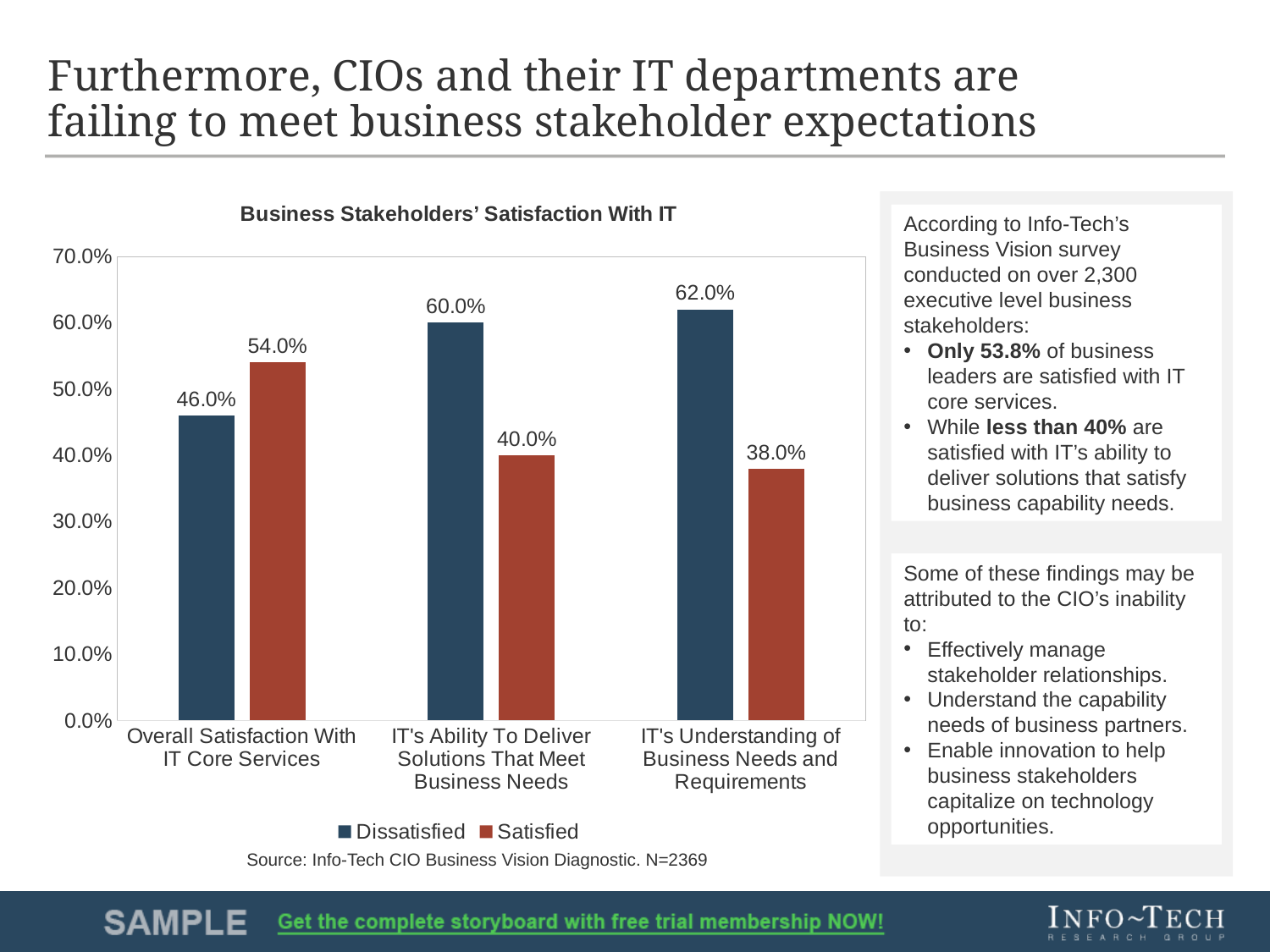
What is the title of the chart? Business Stakeholders' Satisfaction With IT What is the difference between the Dissatisfied and Satisfied values for IT's Ability To Deliver Solutions That Meet Business Needs? 20.0% What is the Satisfied value for IT's Ability To Deliver Solutions That Meet Business Needs? 40.0% How many categories are shown on the x axis? 3 What kind of chart is shown on the slide? Bar chart Which colour represents the Satisfied series in the legend? Red How many series does the legend list? 2 For Overall Satisfaction With IT Core Services, which is larger: the Dissatisfied value or the Satisfied value? Satisfied Which category has the lowest Satisfied value? IT's Understanding of Business Needs and Requirements What is the Dissatisfied value for IT's Understanding of Business Needs and Requirements? 62.0% Which category has the highest Dissatisfied value? IT's Understanding of Business Needs and Requirements What is the Dissatisfied value for Overall Satisfaction With IT Core Services? 46.0%